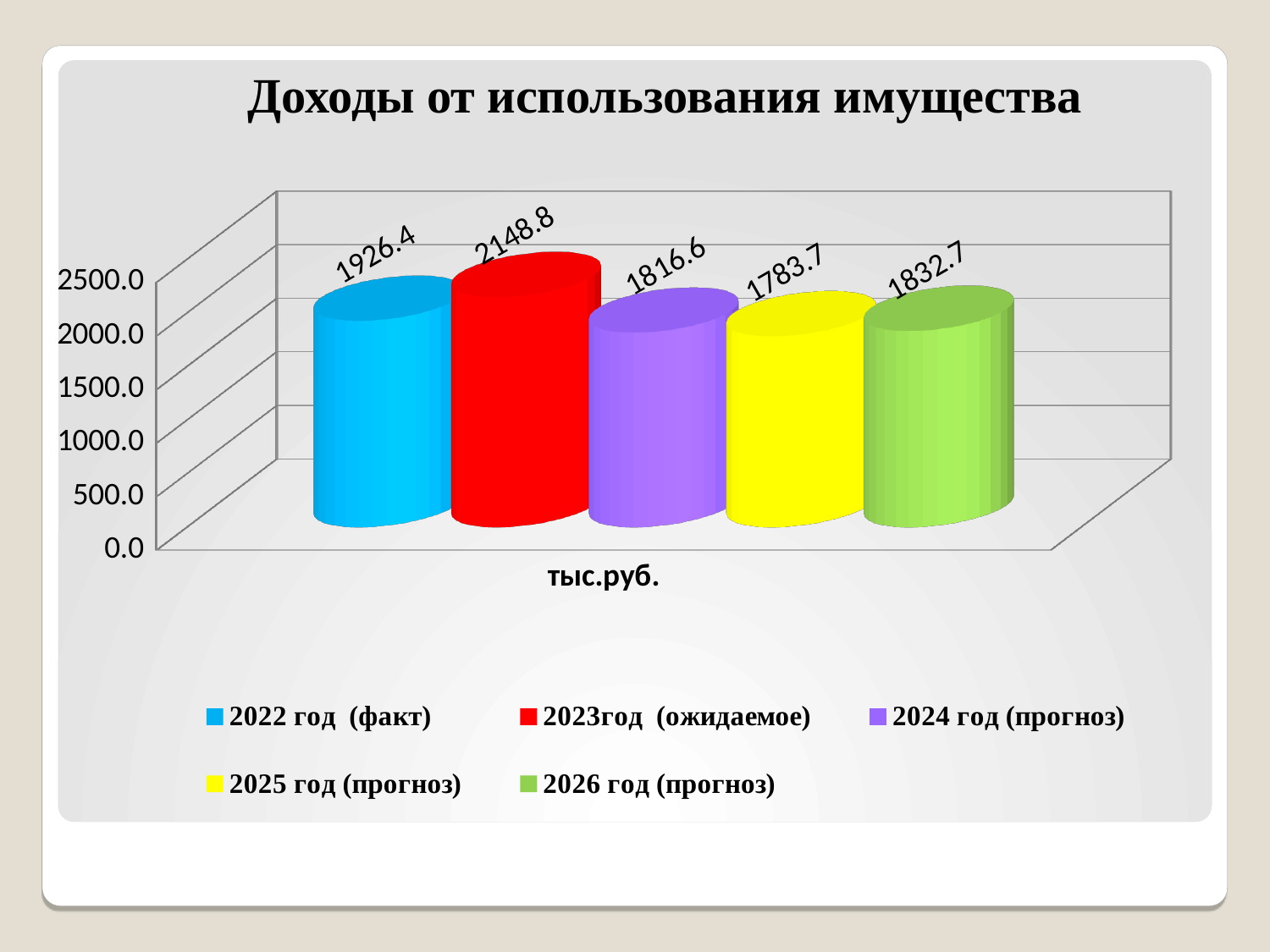
Which series has the highest value? 2023год (ожидаемое) Is the value for 2023год (ожидаемое) greater or less than 2000.0? greater What is the value for 2023год (ожидаемое)? 2148.8 How many series does the legend list? 5 What is the title of the chart? Доходы от использования имущества Which series has the lowest value? 2025 год (прогноз) What is the value for 2025 год (прогноз)? 1783.7 Which is larger, the value for 2024 год (прогноз) or the value for 2026 год (прогноз)? 2026 год (прогноз) What is the value for 2022 год (факт)? 1926.4 What kind of chart is shown on the slide? bar chart What is the value for 2026 год (прогноз)? 1832.7 What is the difference between the values for 2023год (ожидаемое) and 2022 год (факт)? 222.4